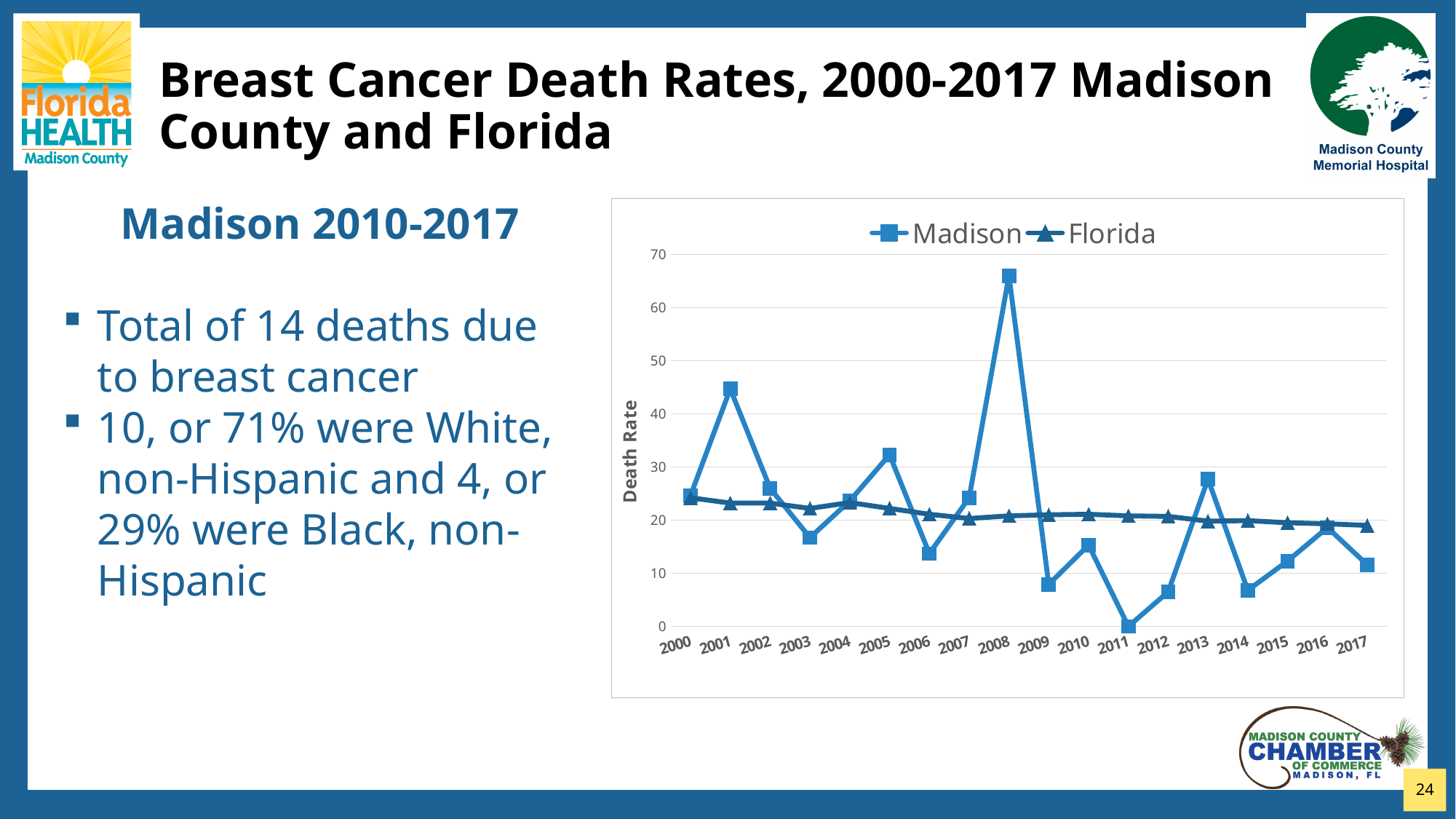
In 2009, which series has the larger value, Madison or Florida? Florida Is the Madison value for 2014 greater or less than 10? less Which two series are listed in the chart's legend? Madison and Florida Does the Florida series generally rise or fall from 2000 to 2017? fall In which year does the Madison series reach its lowest value? 2011 What is the label on the vertical axis of the chart? Death Rate Is the Madison value for 2008 greater or less than 60? greater Is the Madison value for 2001 greater or less than 40? greater How many years are plotted along the x axis of the chart? 18 How many series does the chart's legend list? 2 What kind of chart is shown on the slide? line chart In which year does the Madison series reach its highest value? 2008